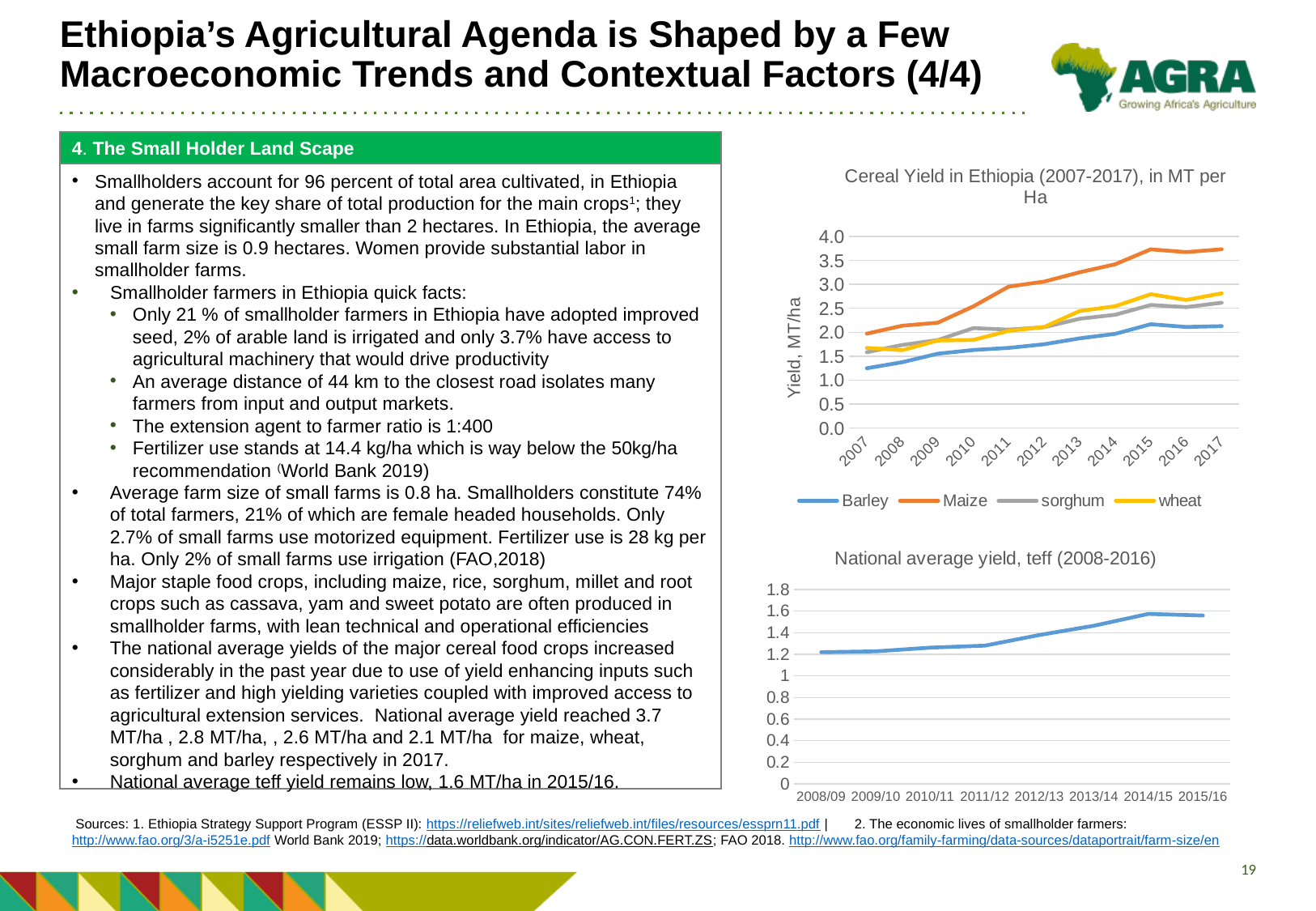
In the 'Cereal Yield in Ethiopia (2007-2017), in MT per Ha' chart, what is the label on the y axis? Yield, MT/ha In the 'Cereal Yield in Ethiopia (2007-2017), in MT per Ha' chart, does the Maize yield generally rise or fall from 2007 to 2017? Rise In the 'Cereal Yield in Ethiopia (2007-2017), in MT per Ha' chart, is the Barley yield in 2007 greater or less than 1.5? less In the 'Cereal Yield in Ethiopia (2007-2017), in MT per Ha' chart, which crop has the lowest yield in 2017? Barley In the 'National average yield, teff (2008-2016)' chart, how many data points are plotted? 8 In the 'Cereal Yield in Ethiopia (2007-2017), in MT per Ha' chart, how many series does the legend list? 4 In the 'National average yield, teff (2008-2016)' chart, is the value for 2014/15 greater or less than 1.4? greater In the 'Cereal Yield in Ethiopia (2007-2017), in MT per Ha' chart, which crop has the highest yield in 2017? Maize In the 'Cereal Yield in Ethiopia (2007-2017), in MT per Ha' chart, which is larger in 2015, the Maize yield or the Barley yield? Maize In the 'Cereal Yield in Ethiopia (2007-2017), in MT per Ha' chart, is the Maize yield in 2017 greater or less than 3.5? greater In the 'Cereal Yield in Ethiopia (2007-2017), in MT per Ha' chart, what kind of chart is shown? Line chart In the 'Cereal Yield in Ethiopia (2007-2017), in MT per Ha' chart, how many years are plotted on the x axis? 11